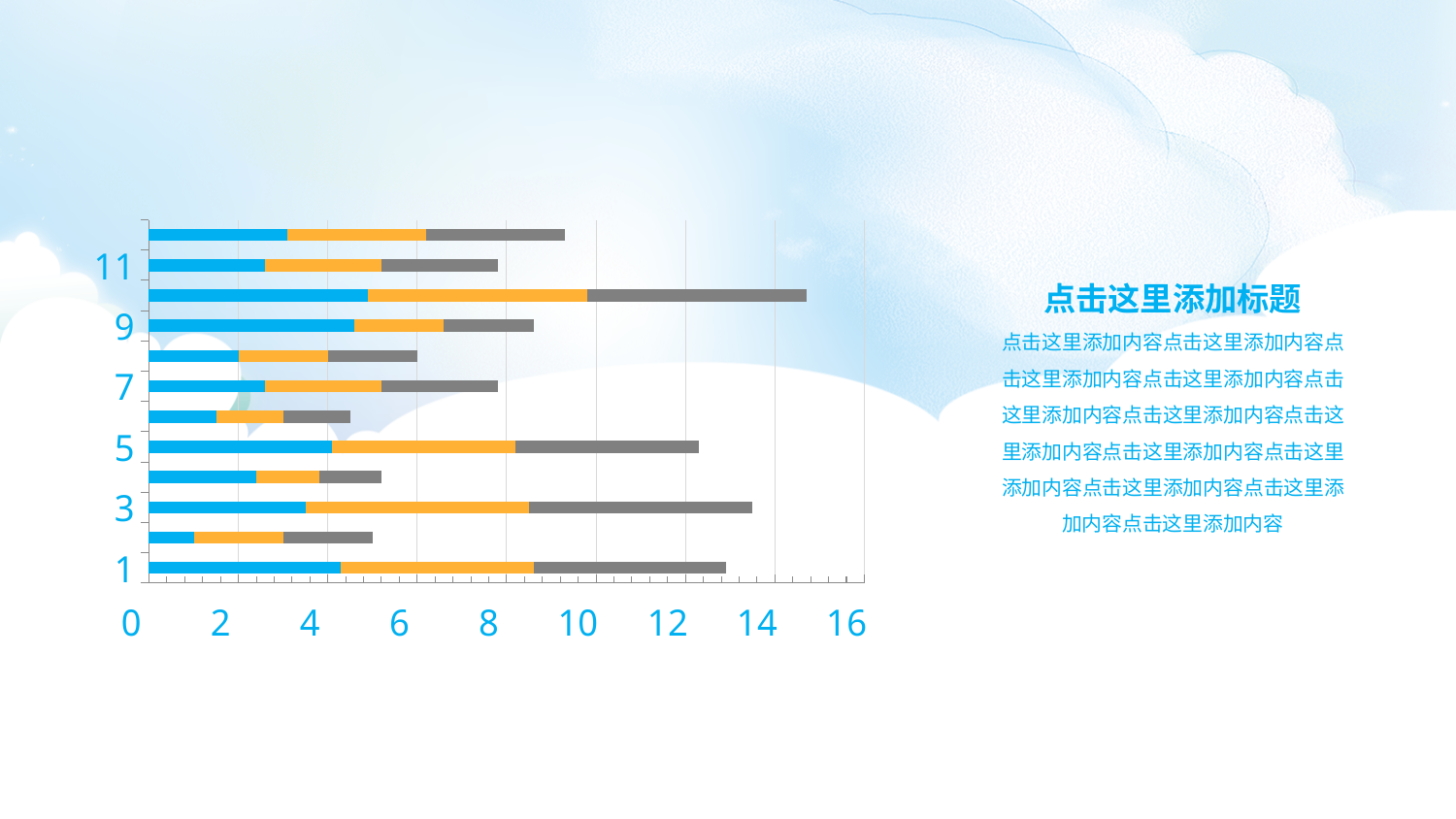
Is the total for category 5 greater or less than 10? greater Which category has the longest bar overall? 10 Which has the longer bar, category 10 or category 1? 10 Which has the longer bar, category 5 or category 7? 5 How many data series (colour segments) make up each bar? 3 Is the total for category 1 greater or less than 12? greater Is the total for category 9 greater or less than 10? less What kind of chart is shown on the slide? Stacked bar chart What is the maximum value shown on the horizontal axis? 16 How many bars (categories) does the chart contain? 12